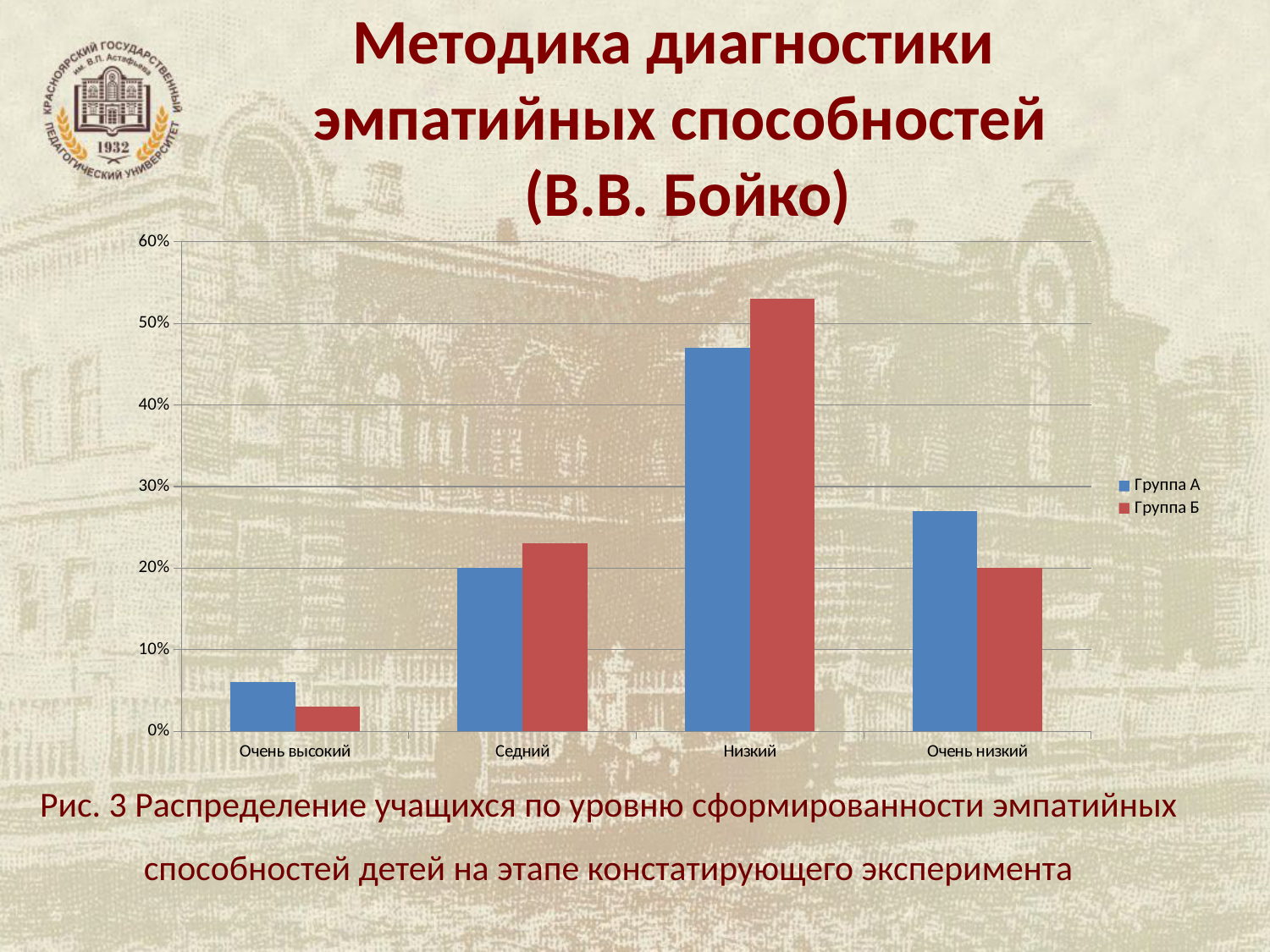
In the Низкий category, which group has the larger value, Группа А or Группа Б? Группа Б Which colour represents Группа Б in the chart? red How many series does the legend list? 2 Which category has the highest value for Группа Б? Низкий What is the value for Группа А in the Седний category? 20% How many categories are shown along the x axis? 4 In the Очень низкий category, which group has the larger value, Группа А or Группа Б? Группа А Is the value for Группа Б in the Низкий category greater or less than 50%? greater Which category has the lowest value for Группа А? Очень высокий What is the value for Группа Б in the Очень низкий category? 20% What kind of chart is shown on the slide? bar chart Is the value for Группа А in the Очень высокий category greater or less than 10%? less